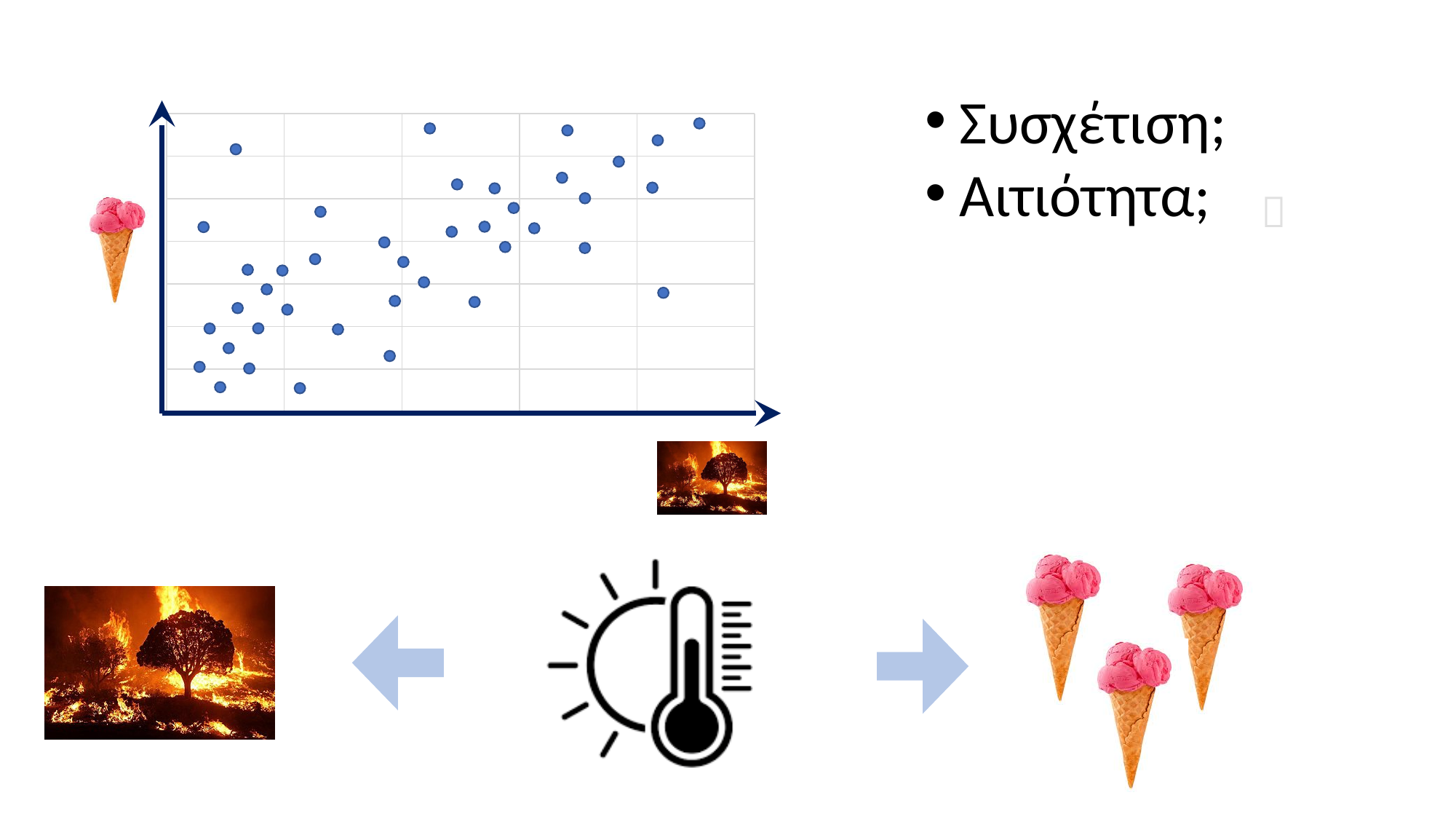
Do the plotted points generally rise or fall as you move from left to right along the x axis? rise What colour are the data points in the scatter chart? blue What picture is placed next to the vertical axis of the scatter chart? an ice cream cone Does the scatter chart show a positive or negative relationship between the two variables? positive What kind of chart is shown on the slide? scatter chart